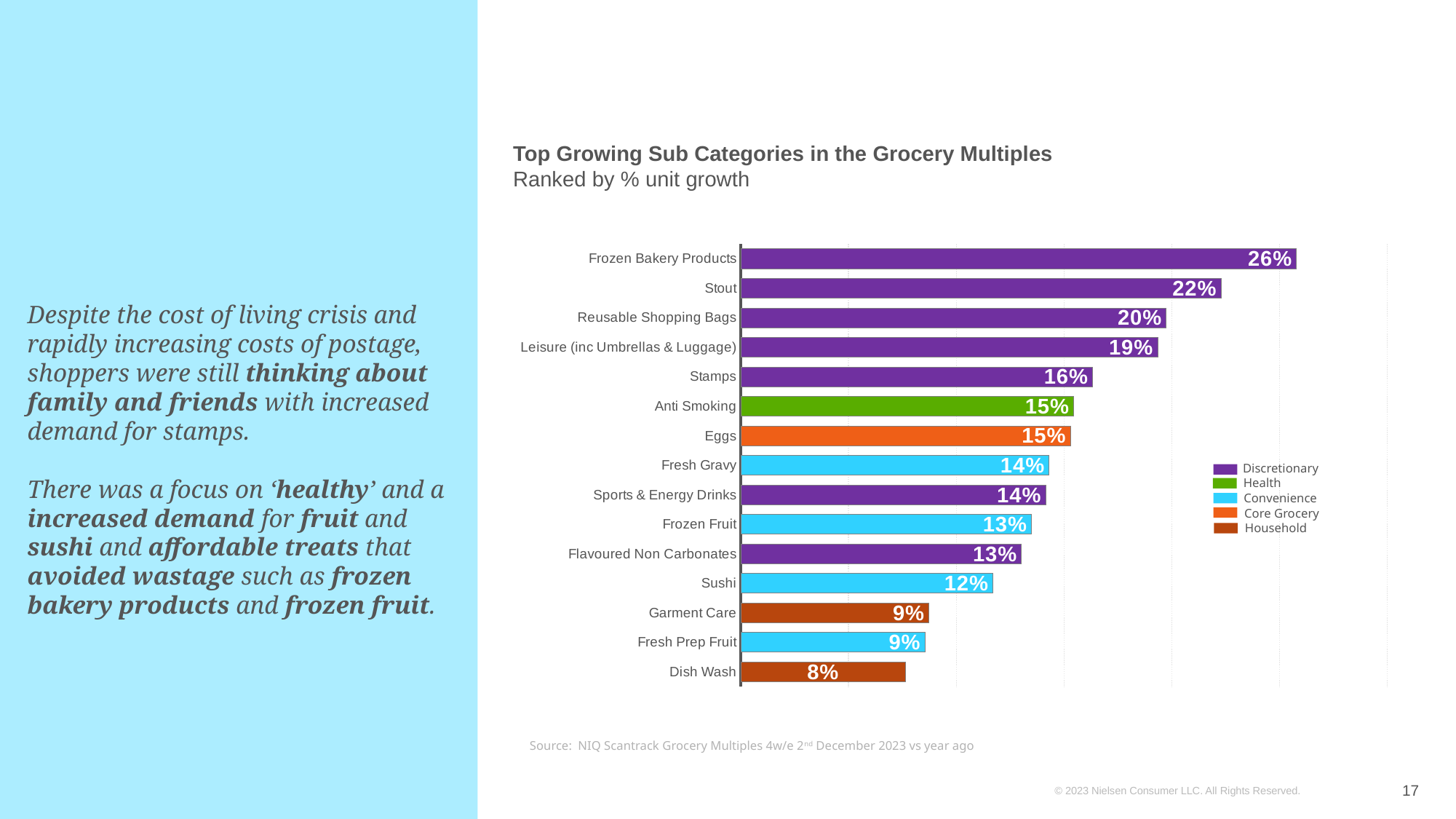
What is the % unit growth for Stamps? 16% What type of chart is shown on the slide? Bar chart What is the difference in % unit growth between Frozen Bakery Products and Stout? 4% Which has higher % unit growth, Leisure (inc Umbrellas & Luggage) or Anti Smoking? Leisure (inc Umbrellas & Luggage) How many sub categories are shown in the chart? 15 How many categories does the legend list? 5 What is the % unit growth for Dish Wash? 8% Which sub category has the lowest % unit growth? Dish Wash What is the % unit growth for Frozen Fruit? 13% What is the difference in % unit growth between Reusable Shopping Bags and Sushi? 8% Which sub category has the highest % unit growth? Frozen Bakery Products Which legend category does the Eggs bar belong to? Core Grocery